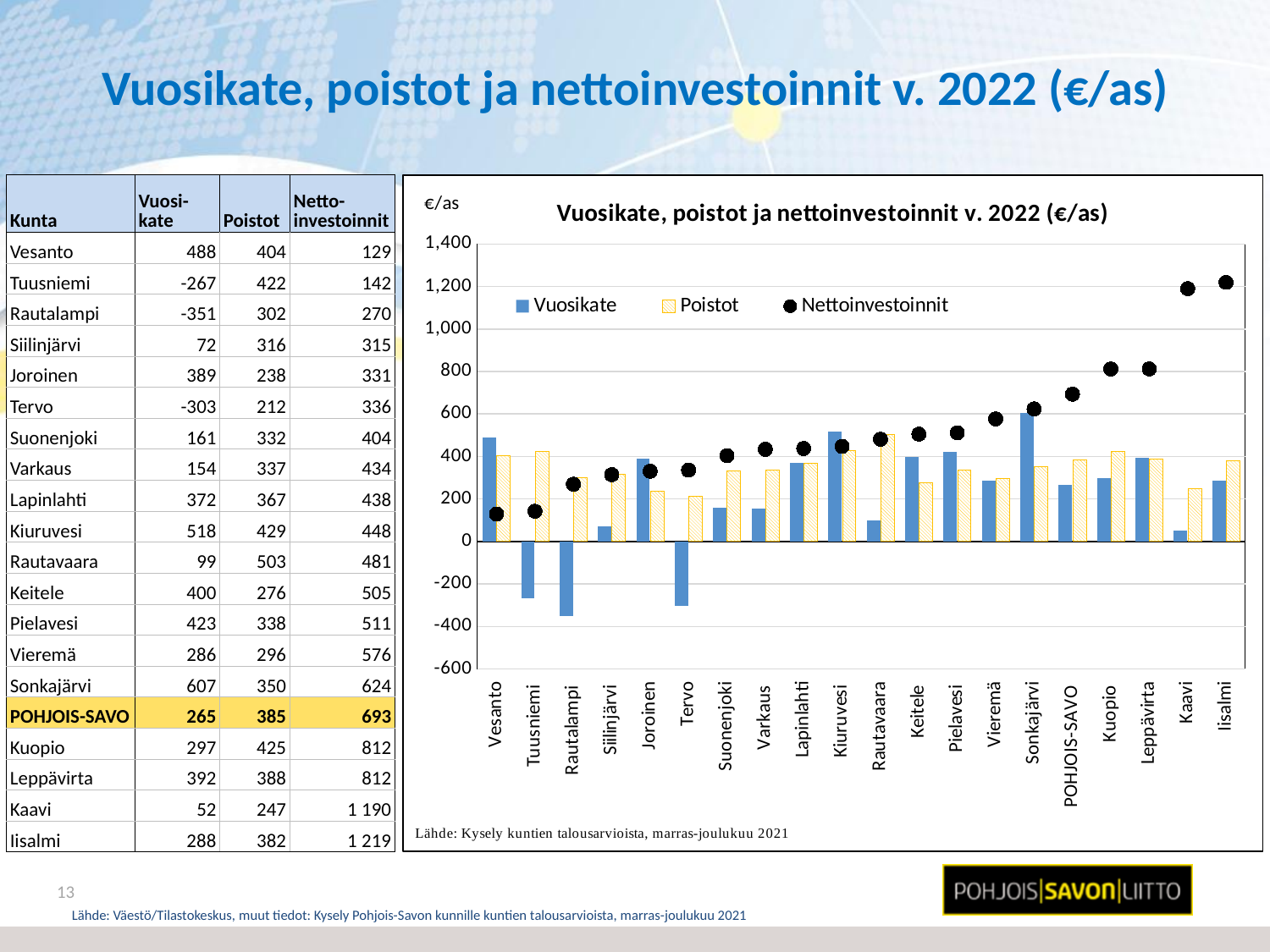
Do the Nettoinvestoinnit values rise or fall from left to right along the x axis? rise How many series does the chart legend list? 3 What kind of chart is shown on the slide? bar chart (with dot markers for Nettoinvestoinnit) What is the Nettoinvestoinnit value for Kaavi? 1 190 Which category has the highest Vuosikate value? Sonkajärvi Which category has the highest Nettoinvestoinnit value? Iisalmi Which category has the lowest Vuosikate value? Rautalampi What is the Vuosikate value for Sonkajärvi? 607 What is the Poistot value for Rautavaara? 503 What is the difference between the Nettoinvestoinnit values for Iisalmi and Kaavi? 29 How many categories are shown along the x axis of the chart? 20 Is the Nettoinvestoinnit value for Kuopio greater or less than 1,000? less